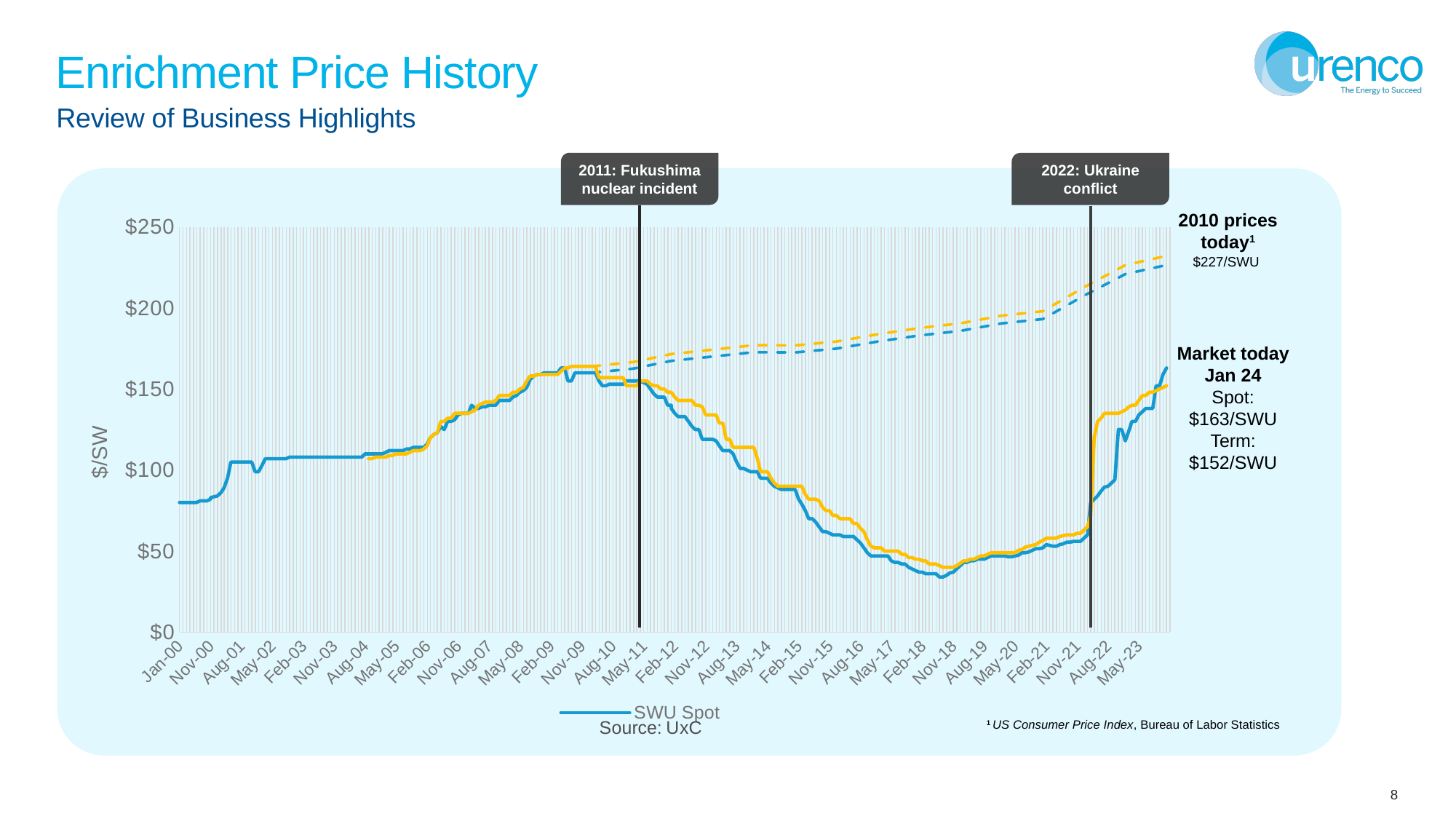
Is the SWU Spot value at Jan-00 greater or less than $100? less What is the difference between the Jan 24 spot price and the Jan 24 term price? $11/SWU According to the 'Market today Jan 24' annotation, what is the spot price? $163/SWU Which is larger in the Jan 24 market annotation, the spot price or the term price? Spot What kind of chart is shown on the slide? line chart According to the 'Market today Jan 24' annotation, what is the term price? $152/SWU Is the SWU Spot value around Feb-18 greater or less than $50? less What event is annotated on the chart for 2022? Ukraine conflict How many series does the legend list? 1 What value is given for '2010 prices today'? $227/SWU Does the SWU Spot line rise or fall between Feb-09 and Feb-18? fall Is the SWU Spot value around Feb-09 greater or less than $150? greater